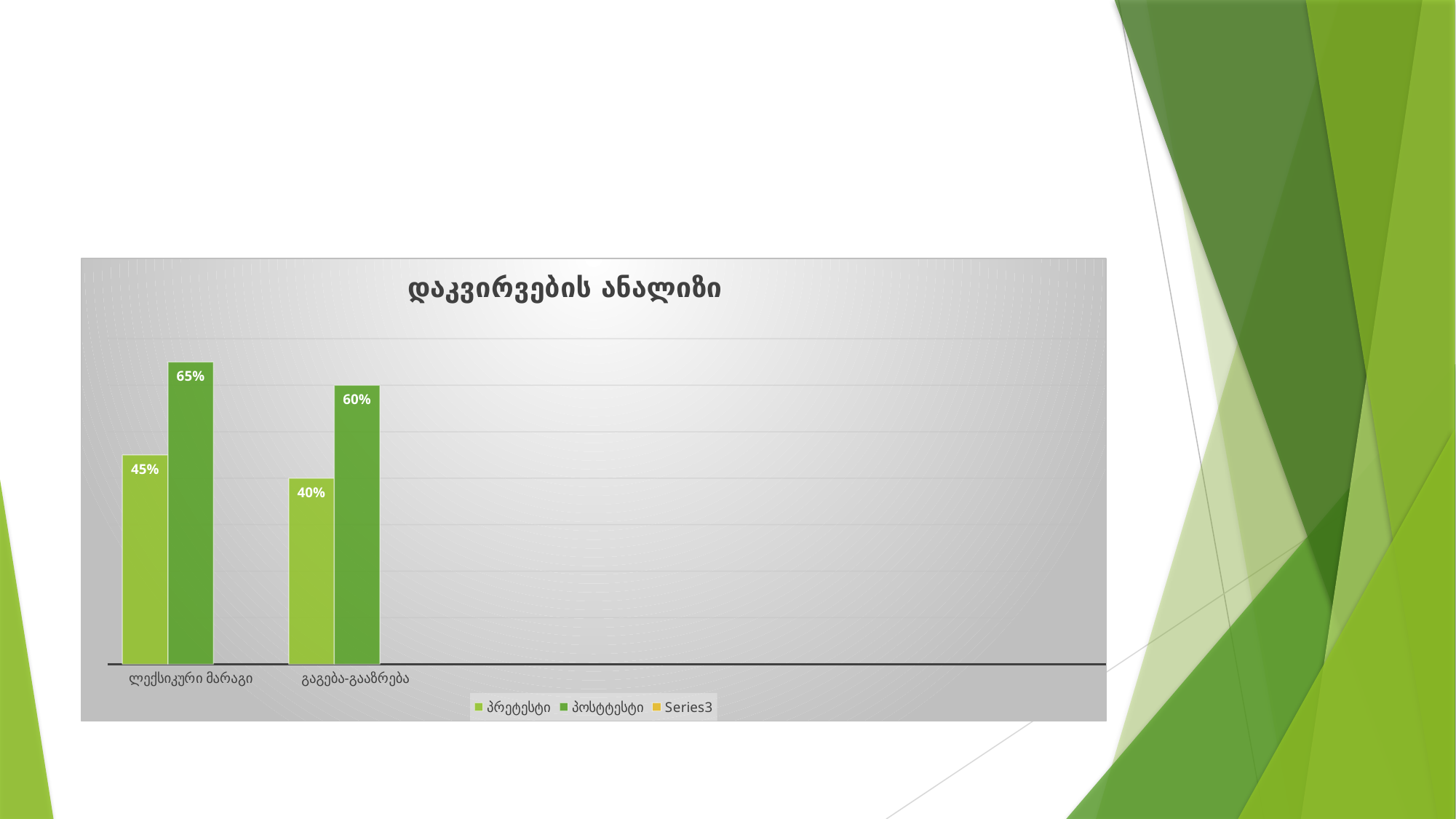
What is the პოსტტესტი value for ლექსიკური მარაგი? 65% What is the პოსტტესტი value for გაგება-გააზრება? 60% Which category has the lowest პრეტესტი value? გაგება-გააზრება Which category has the highest პოსტტესტი value? ლექსიკური მარაგი What is the პრეტესტი value for გაგება-გააზრება? 40% How many categories are shown on the x axis? 2 What type of chart is shown on the slide? bar chart What is the title of the chart? დაკვირვების ანალიზი Which is larger for გაგება-გააზრება: the პრეტესტი value or the პოსტტესტი value? პოსტტესტი What is the difference between the პოსტტესტი and პრეტესტი values for ლექსიკური მარაგი? 20% How many series does the legend list? 3 What is the პრეტესტი value for ლექსიკური მარაგი? 45%